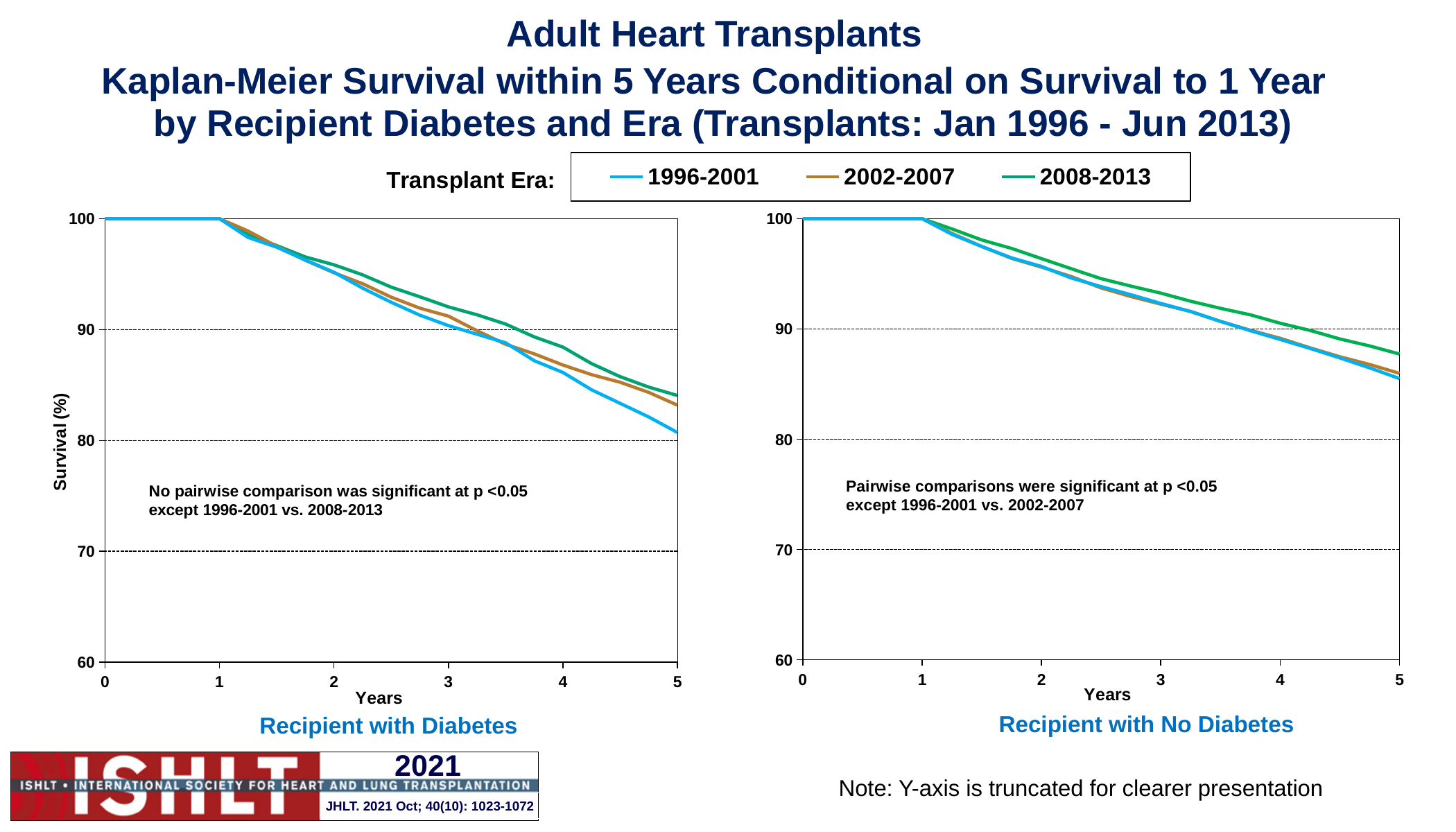
In the 'Recipient with Diabetes' chart, which era has the lowest survival at year 5? 1996-2001 In the 'Recipient with No Diabetes' chart, do the survival curves rise or fall from year 1 to year 5? Fall In the 'Recipient with Diabetes' chart, what is the survival (%) for all eras at year 1? 100 In the 'Recipient with Diabetes' chart, is the survival for 2008-2013 at year 5 greater or less than 80? greater In the 'Recipient with No Diabetes' chart, is the survival for 2008-2013 at year 5 greater or less than 90? less How many transplant eras does the legend list? 3 In the 'Recipient with No Diabetes' chart, which era has the highest survival at year 5? 2008-2013 What is the label of the y-axis on the left chart? Survival (%) What kind of chart is the 'Recipient with Diabetes' chart on the left? Line chart In the 'Recipient with No Diabetes' chart, which is higher at year 4: 2008-2013 or 1996-2001? 2008-2013 In the 'Recipient with Diabetes' chart, is the survival for 2008-2013 at year 3 greater or less than 90? greater